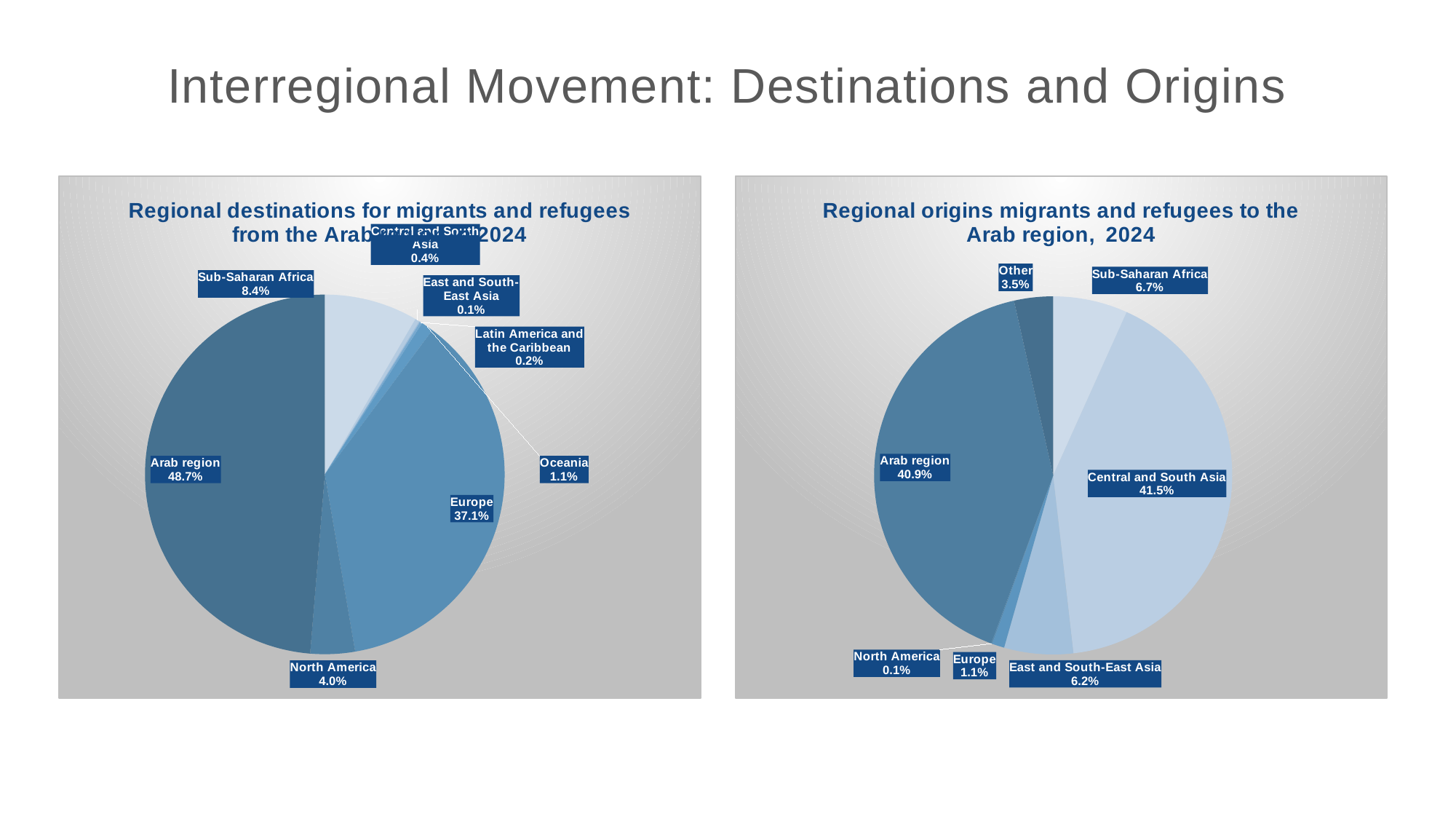
In the right chart (Regional origins migrants and refugees to the Arab region, 2024), what share comes from Central and South Asia? 41.5% What type of chart is used on the right side of the slide? Pie chart In the left chart (Regional destinations), what is the difference between the Arab region share and the Europe share? 11.6% In the left chart (Regional destinations), how many slices does the pie have? 8 In the right chart (Regional origins), which origin region has the largest share? Central and South Asia In the left chart (Regional destinations), what share goes to Sub-Saharan Africa? 8.4% In the right chart (Regional origins), which is larger: the share from Sub-Saharan Africa or the share from East and South-East Asia? Sub-Saharan Africa In the right chart (Regional origins), what share comes from East and South-East Asia? 6.2% In the left chart (Regional destinations for migrants and refugees from the Arab region, 2024), what share goes to Europe? 37.1% In the left chart (Regional destinations), which destination region has the largest share? Arab region In the left chart (Regional destinations), which destination region has the smallest share? East and South-East Asia In the right chart (Regional origins), how many slices does the pie have? 7